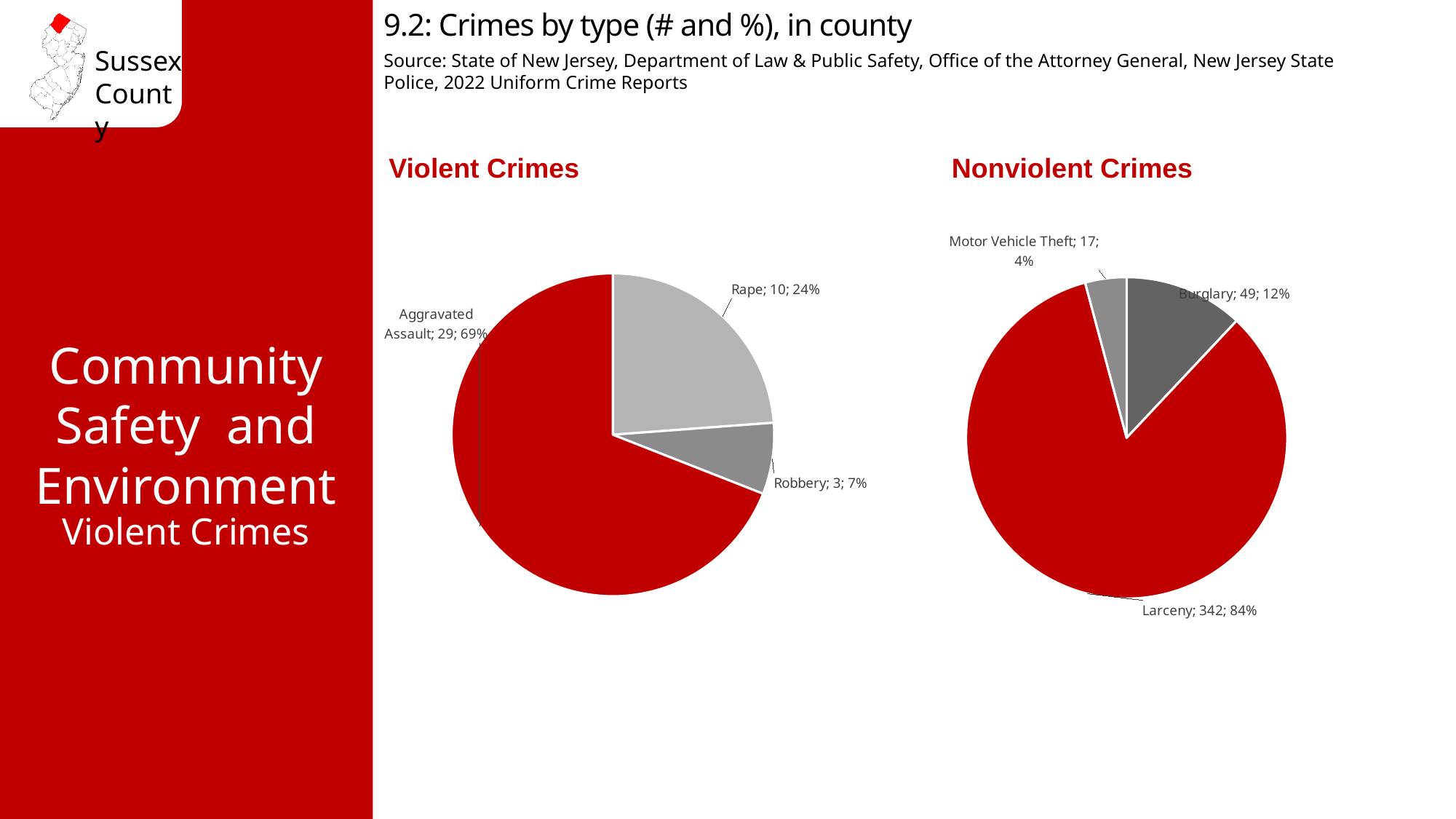
In the Nonviolent Crimes chart, how many larcenies are shown? 342 In the Violent Crimes chart, what percentage of violent crimes is rape? 24% What type of chart is used for the Violent Crimes data? Pie chart What is the title of the chart on the right side of the slide? Nonviolent Crimes In the Violent Crimes chart, how many categories are shown? 3 In the Nonviolent Crimes chart, which category has the largest slice? Larceny In the Nonviolent Crimes chart, what percentage of nonviolent crimes is motor vehicle theft? 4% In the Violent Crimes chart, which category has the smallest slice? Robbery In the Nonviolent Crimes chart, which is larger, burglary or motor vehicle theft? Burglary In the Violent Crimes chart, what is the difference between the number of aggravated assaults and the number of rapes? 19 In the Violent Crimes chart, how many aggravated assaults are shown? 29 In the Nonviolent Crimes chart, what is the difference between the number of burglaries and the number of motor vehicle thefts? 32